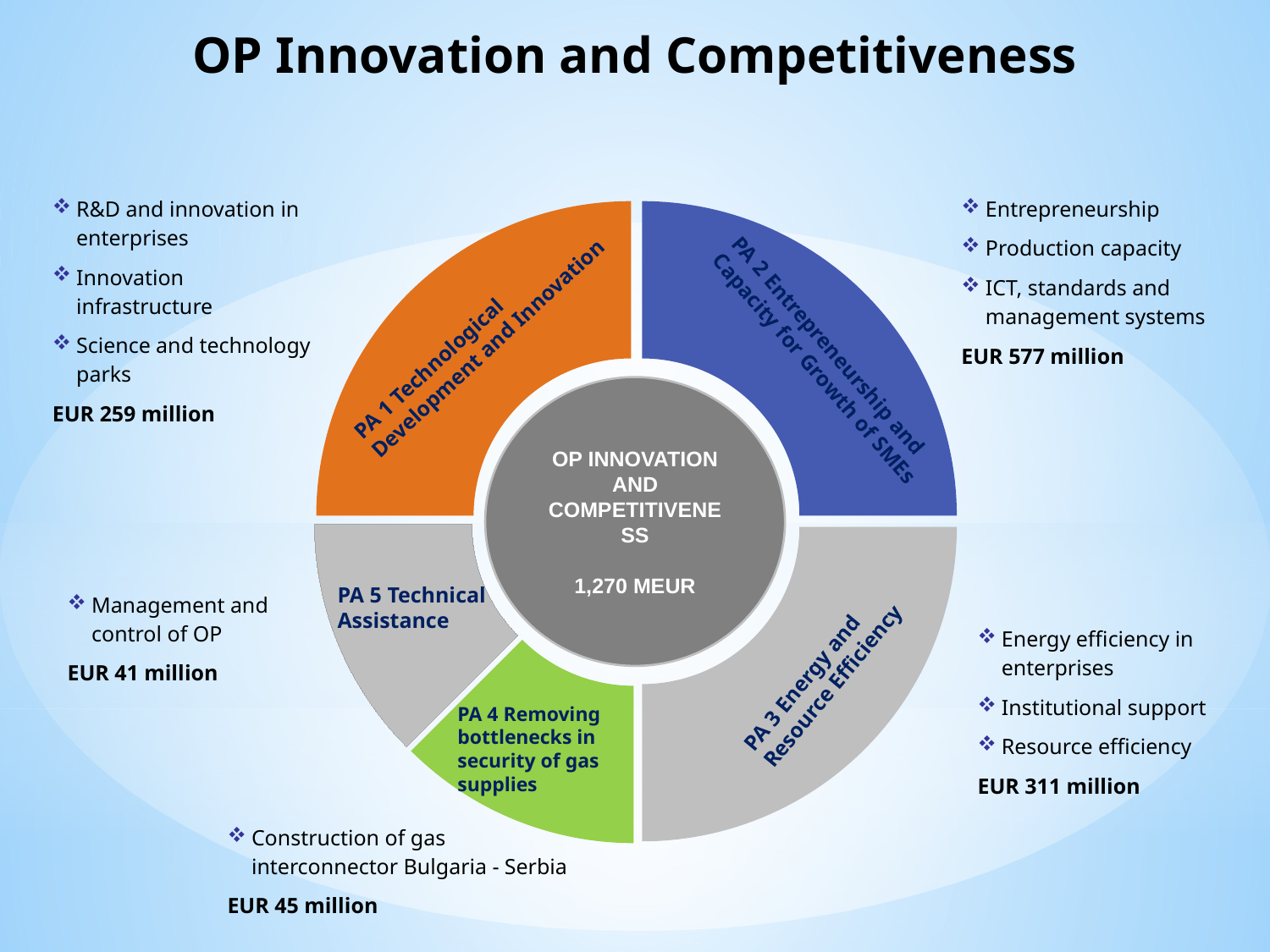
What is the budget for PA 3 Energy and Resource Efficiency? EUR 311 million What is the budget for PA 2 Entrepreneurship and Capacity for Growth of SMEs? EUR 577 million What is the budget for PA 4 Removing bottlenecks in security of gas supplies? EUR 45 million What is the budget for PA 1 Technological Development and Innovation? EUR 259 million How many priority axis segments does the chart have? 5 Which priority axis has the largest budget? PA 2 Entrepreneurship and Capacity for Growth of SMEs What is the budget for PA 5 Technical Assistance? EUR 41 million What total amount is shown in the centre of the chart? 1,270 MEUR Which priority axis has the smallest budget? PA 5 Technical Assistance Which has a larger budget, PA 3 Energy and Resource Efficiency or PA 1 Technological Development and Innovation? PA 3 Energy and Resource Efficiency What kind of chart is shown on the slide? Pie (donut) chart What is the difference between the budgets of PA 2 and PA 1? EUR 318 million